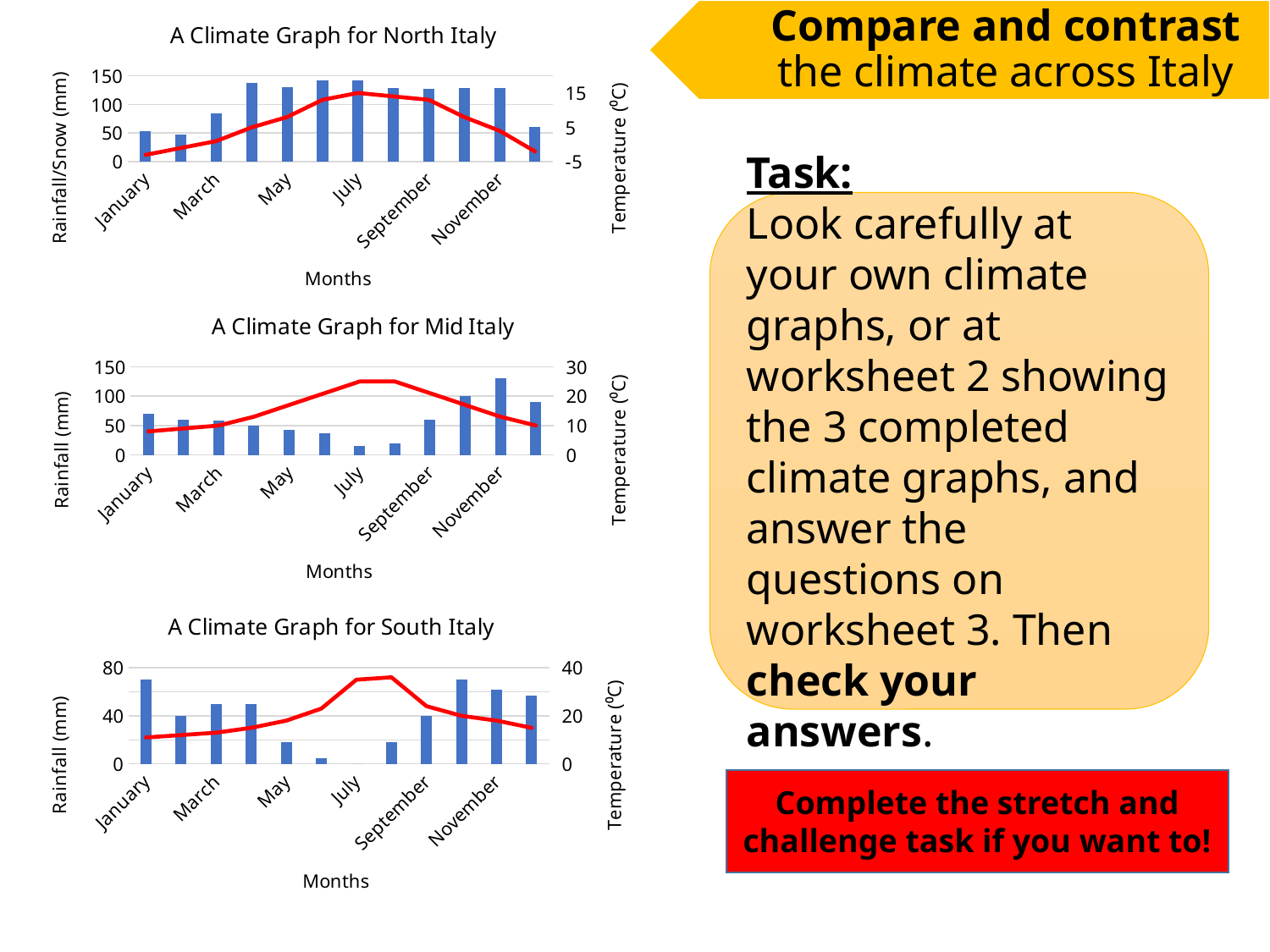
In 'A Climate Graph for Mid Italy', which is larger, the rainfall for November or the rainfall for January? November How many months are plotted on the x axis of 'A Climate Graph for South Italy'? 12 What is the label on the left vertical axis of 'A Climate Graph for North Italy'? Rainfall/Snow (mm) In 'A Climate Graph for North Italy', is the rainfall/snow value for April greater or less than 100? greater In 'A Climate Graph for South Italy', is the temperature value for July greater or less than 20? greater In 'A Climate Graph for North Italy', does the temperature line rise or fall from January to July? rise What kind of chart is 'A Climate Graph for North Italy'? A combined bar and line chart In 'A Climate Graph for Mid Italy', is the rainfall value for July greater or less than 50? less In 'A Climate Graph for South Italy', which month has the lowest rainfall? July In 'A Climate Graph for Mid Italy', which month has the highest rainfall? November In 'A Climate Graph for Mid Italy', does rainfall rise or fall from January to July? fall